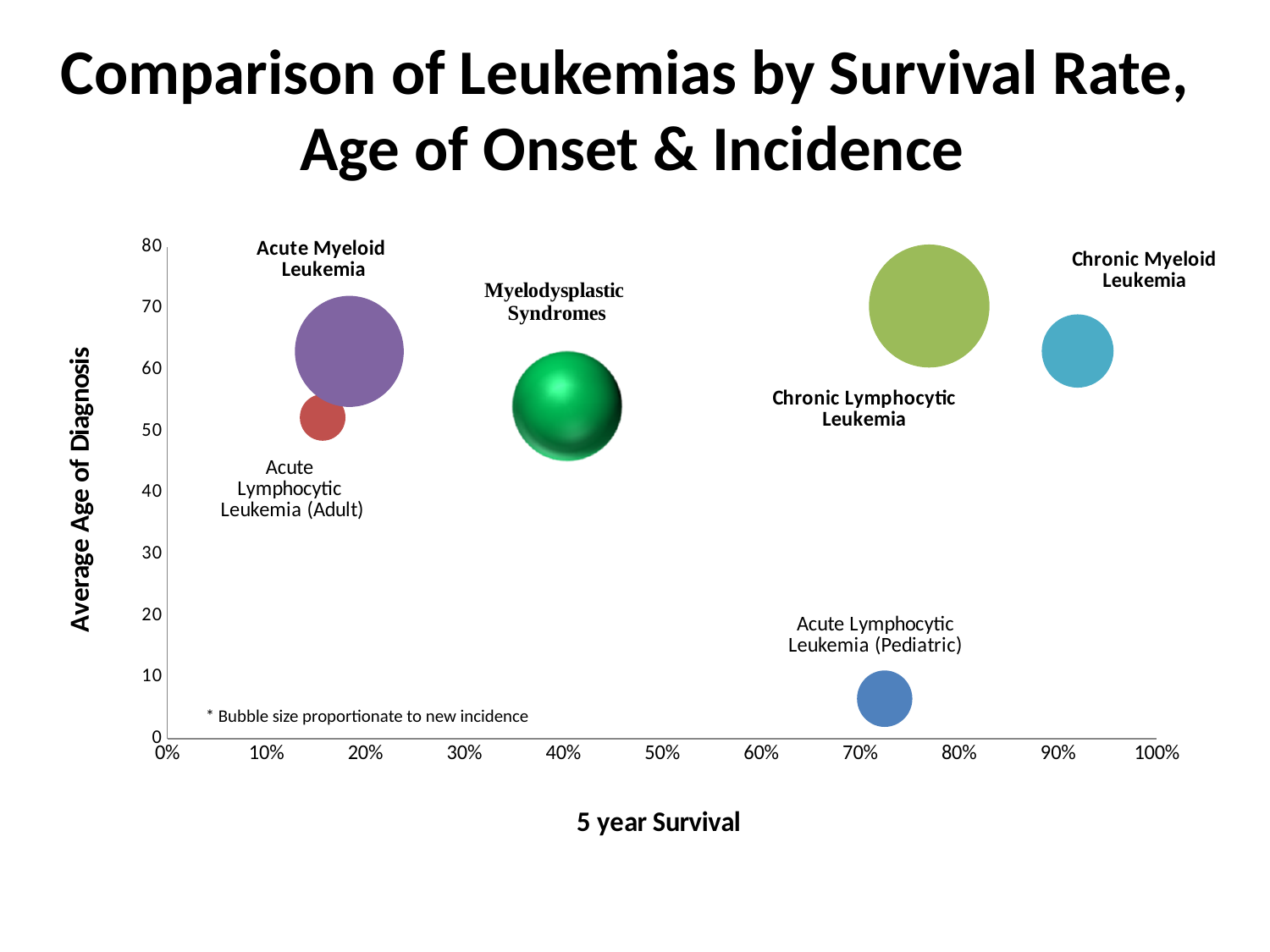
Is the average age of diagnosis for Acute Lymphocytic Leukemia (Pediatric) greater or less than 10? less What is the title of the horizontal axis? 5 year Survival Is the 5 year survival for Acute Lymphocytic Leukemia (Pediatric) greater or less than 60%? greater Which has a higher 5 year survival rate: Chronic Lymphocytic Leukemia or Myelodysplastic Syndromes? Chronic Lymphocytic Leukemia How many leukemia types (bubbles) are plotted on the chart? 6 Which leukemia type has the lowest average age of diagnosis? Acute Lymphocytic Leukemia (Pediatric) What kind of chart is shown on the slide? bubble chart Which has a higher average age of diagnosis: Acute Myeloid Leukemia or Acute Lymphocytic Leukemia (Adult)? Acute Myeloid Leukemia According to the note on the chart, what is bubble size proportionate to? new incidence Which leukemia type has the highest average age of diagnosis? Chronic Lymphocytic Leukemia Is the 5 year survival for Acute Myeloid Leukemia greater or less than 30%? less Which leukemia type has the highest 5 year survival rate? Chronic Myeloid Leukemia